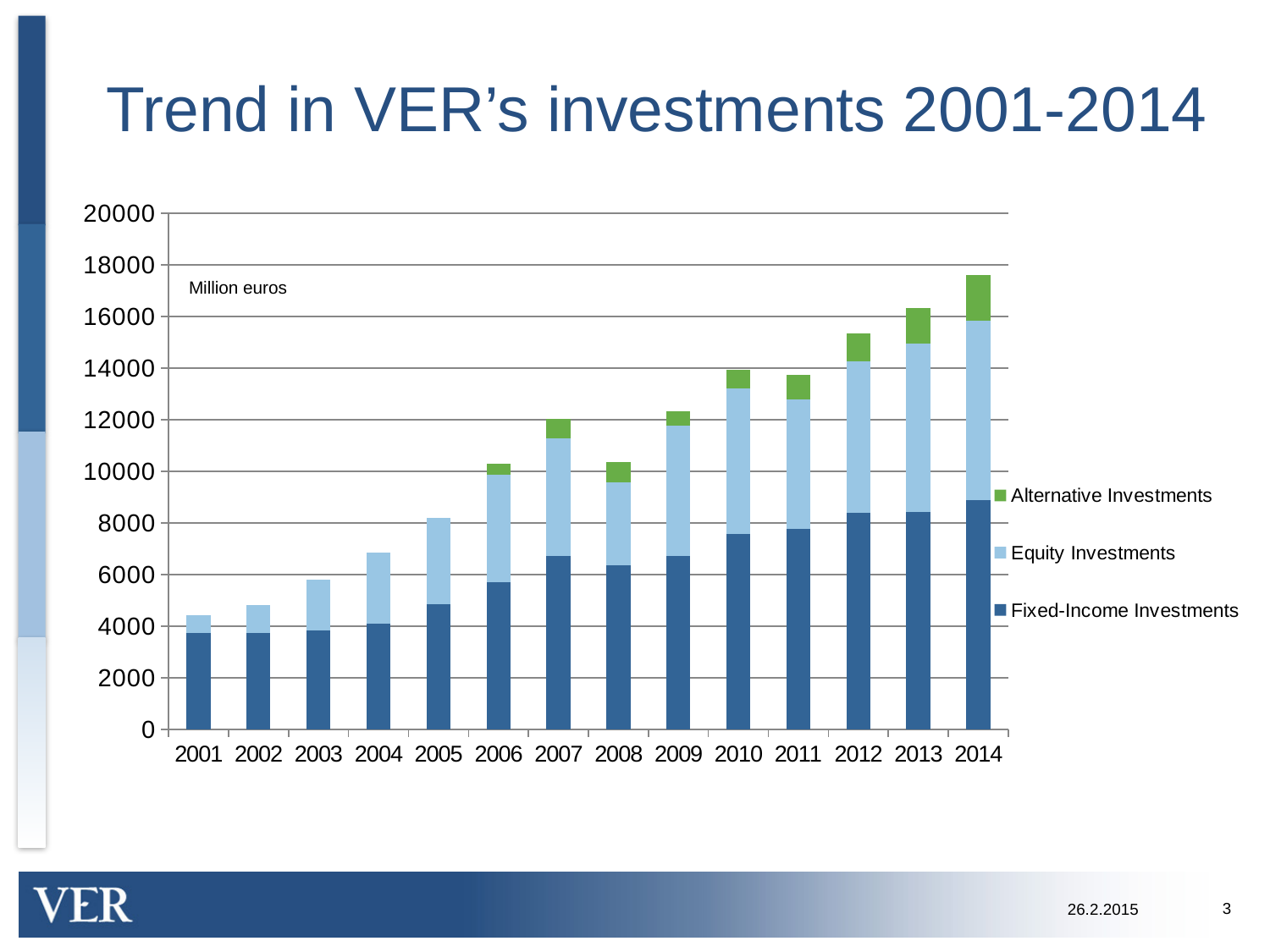
How many years are shown on the x axis of the chart? 14 In what unit are the values in the chart expressed, according to the label on the chart? Million euros What kind of chart is shown on the slide? Stacked bar chart Do total investments generally rise or fall from 2001 to 2014? rise Is the Fixed-Income Investments value for 2014 greater or less than 8000? greater How many series does the chart's legend list? 3 Which year has the larger total investments, 2007 or 2008? 2007 Is the total value for 2008 greater or less than 12000? less Which year has the lowest total investments in the chart? 2001 Is the total value for 2014 greater or less than 16000? greater Which year has the highest total investments in the chart? 2014